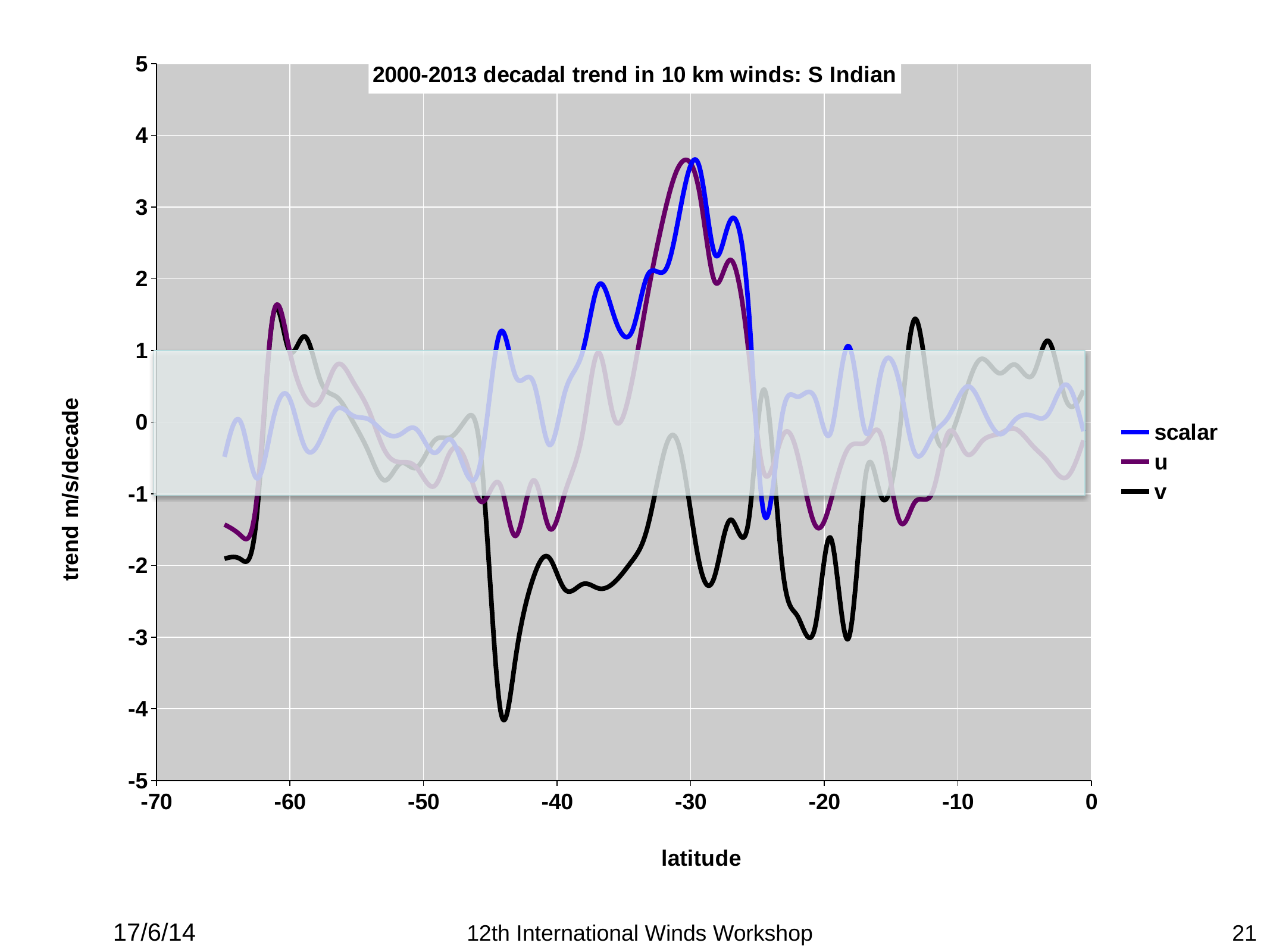
Is the value of the u series near latitude -61 greater or less than 1? greater Is the peak value of the scalar series near latitude -30 greater or less than 3? greater What kind of chart is shown on the slide? line chart What is the title of the chart? 2000-2013 decadal trend in 10 km winds: S Indian Which series reaches the lowest value on the chart? v How many series does the legend list? 3 Is the value of the v series near latitude -21 greater or less than -2? less Does the v series rise or fall between latitude -45 and -44? fall Near latitude -44, which series has the larger value, scalar or v? scalar What is the label of the vertical axis? trend m/s/decade